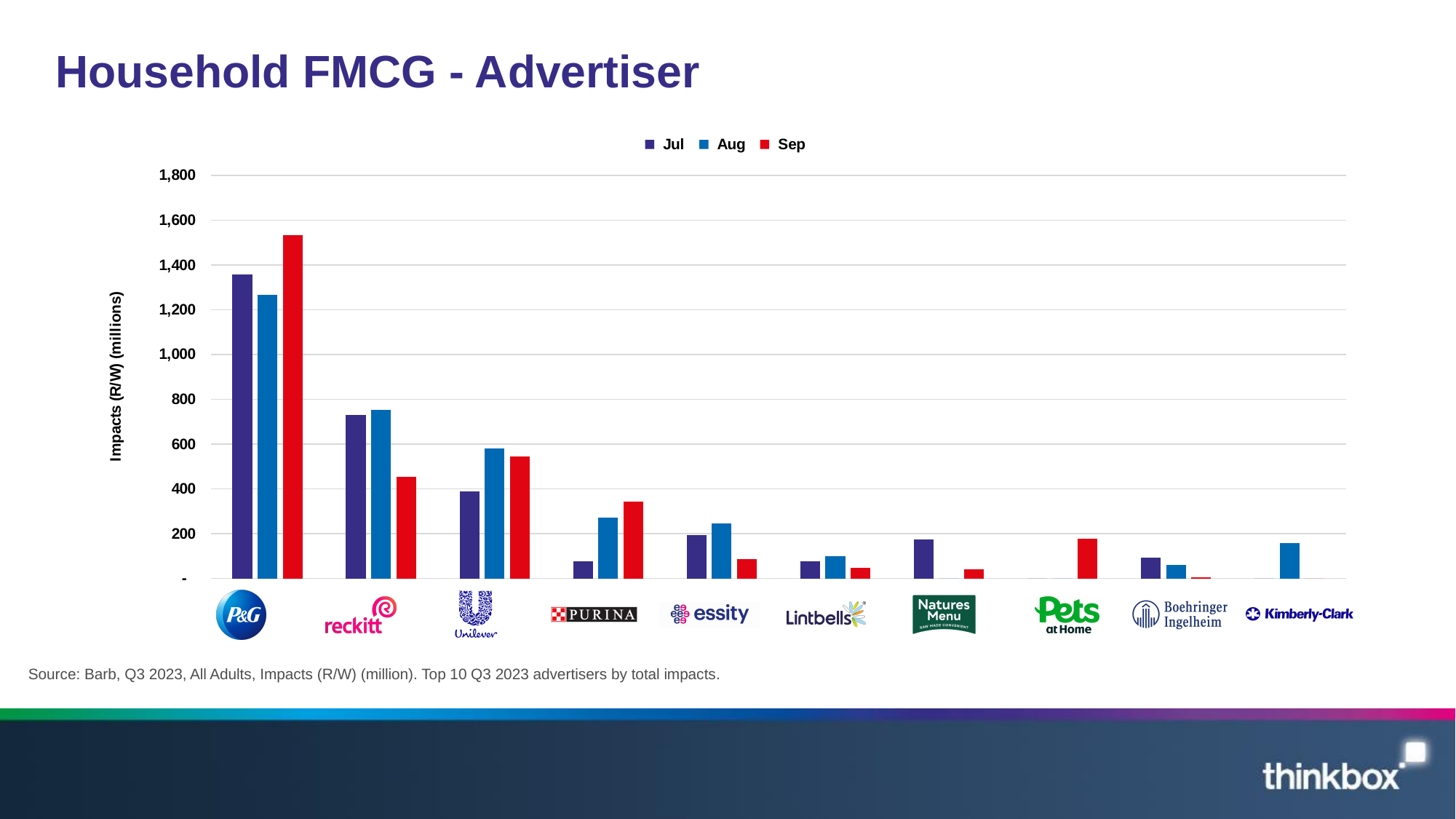
Which month has the lowest value for Essity? Sep Do Purina's values rise or fall from Jul through Sep? rise Is the Aug value for P&G greater or less than 1,200? greater Which advertiser has the highest Sep value? P&G Is the Sep value for Reckitt greater or less than 600? less For Purina, which is larger: the Aug value or the Sep value? Sep How many series does the legend list? 3 What type of chart is shown on the slide? Bar chart How many advertisers are shown along the x axis? 10 What is the label on the y axis? Impacts (R/W) (millions) For Reckitt, which is larger: the Jul value or the Sep value? Jul Is the Sep value for P&G greater or less than 1,400? greater